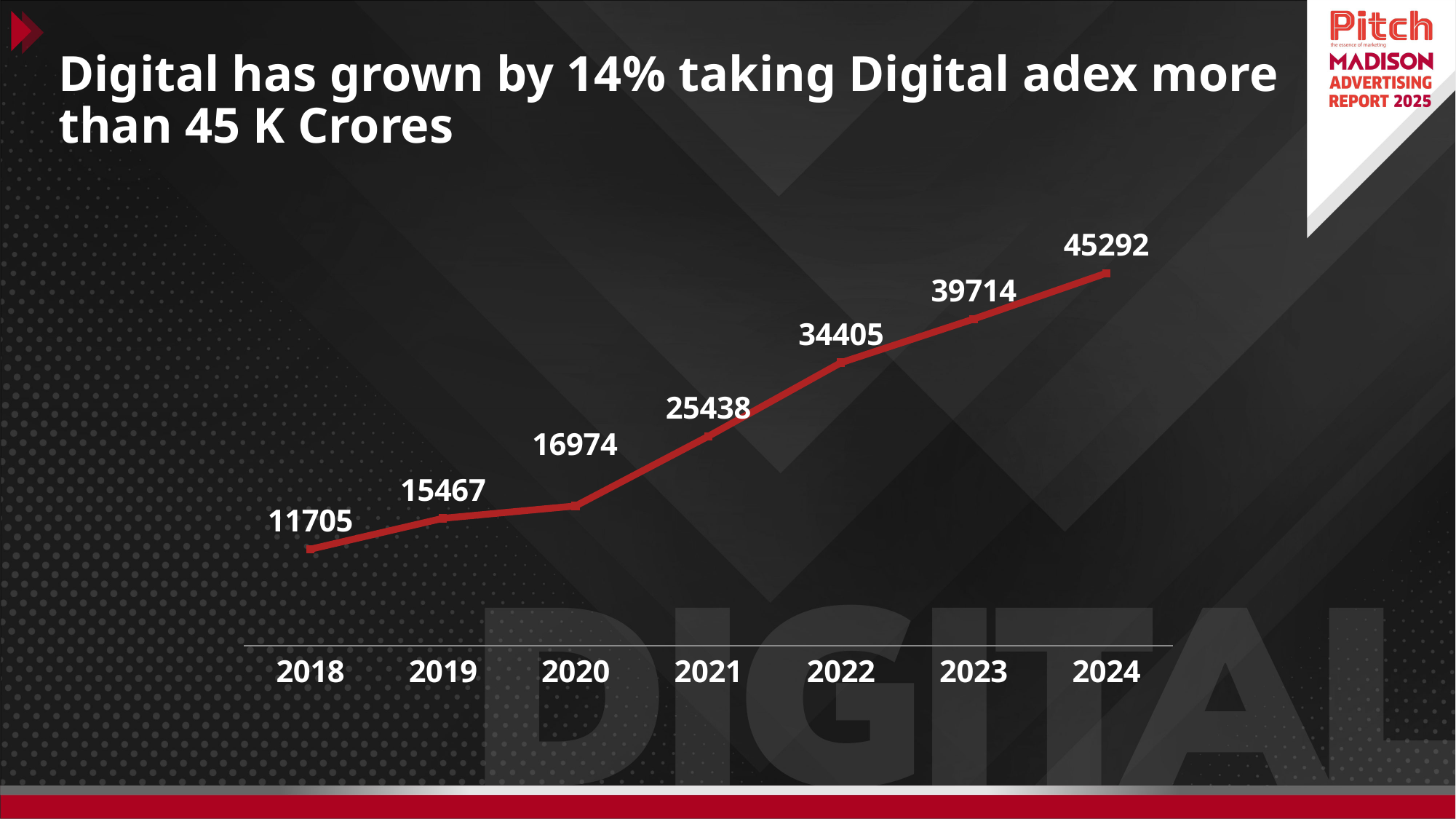
Which year has the lowest value? 2018 What is the difference between the values for 2024 and 2023? 5578 What is the value for 2024? 45292 Which is larger, the value for 2020 or the value for 2019? 2020 Do the values rise or fall from 2018 to 2024? rise What colour is the line on the chart? red What kind of chart is shown on the slide? line chart Which year has the highest value? 2024 What is the value for 2018? 11705 How many years are plotted on the chart? 7 What is the value for 2021? 25438 What is the difference between the values for 2022 and 2021? 8967